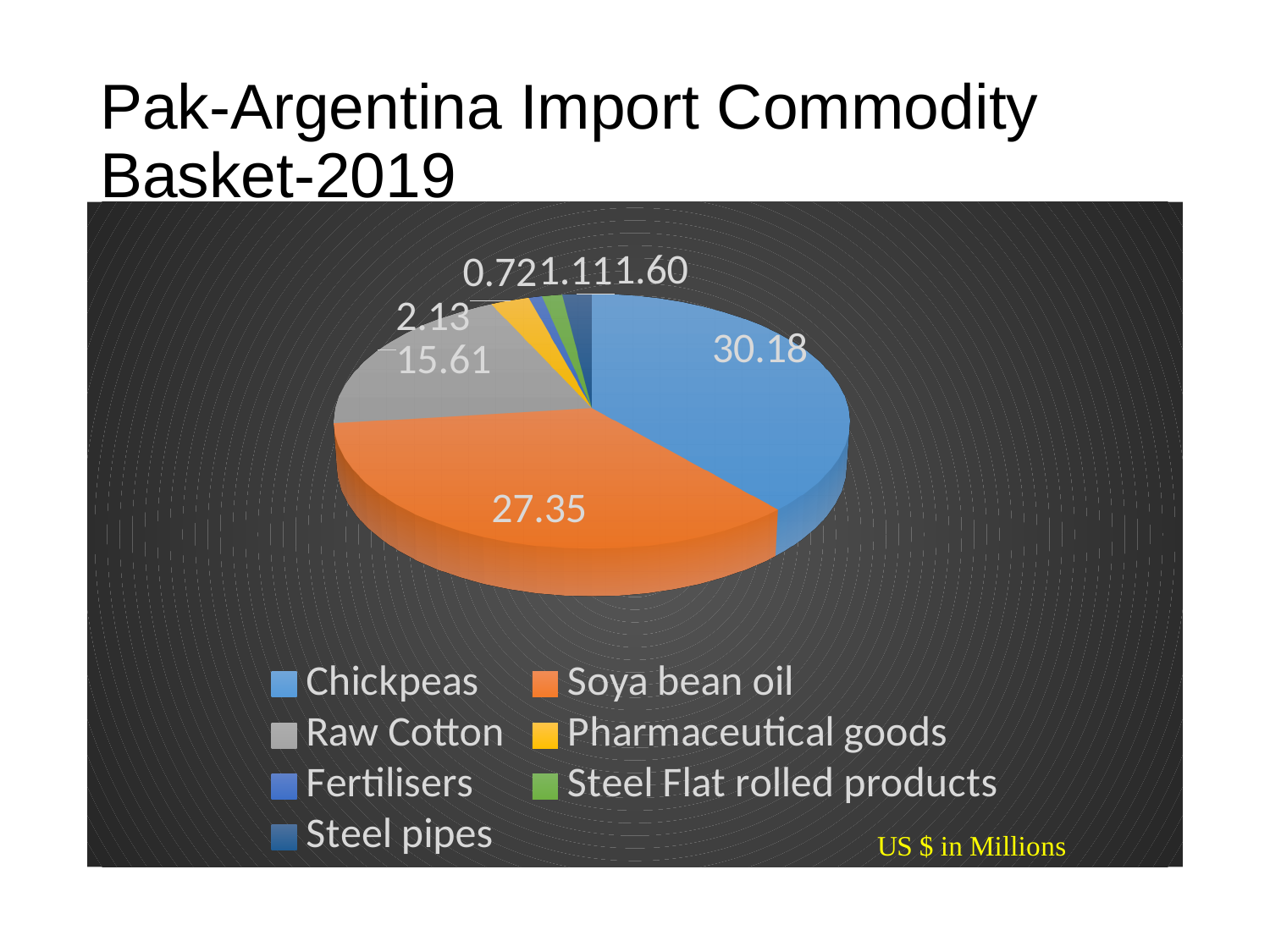
What is the value for Soya bean oil? 27.35 What is the value for Raw Cotton? 15.61 How many commodities are listed in the legend? 7 What is the difference between the values for Chickpeas and Soya bean oil? 2.83 Which commodity has the smallest slice of the pie? Fertilisers What is the difference between the values for Soya bean oil and Raw Cotton? 11.74 What is the value for Chickpeas? 30.18 Which commodity has the largest slice of the pie? Chickpeas What unit is stated for the values in the chart? US $ in Millions What kind of chart is shown on the slide? Pie chart What is the value for Pharmaceutical goods? 2.13 Which is larger, the value for Raw Cotton or the value for Pharmaceutical goods? Raw Cotton